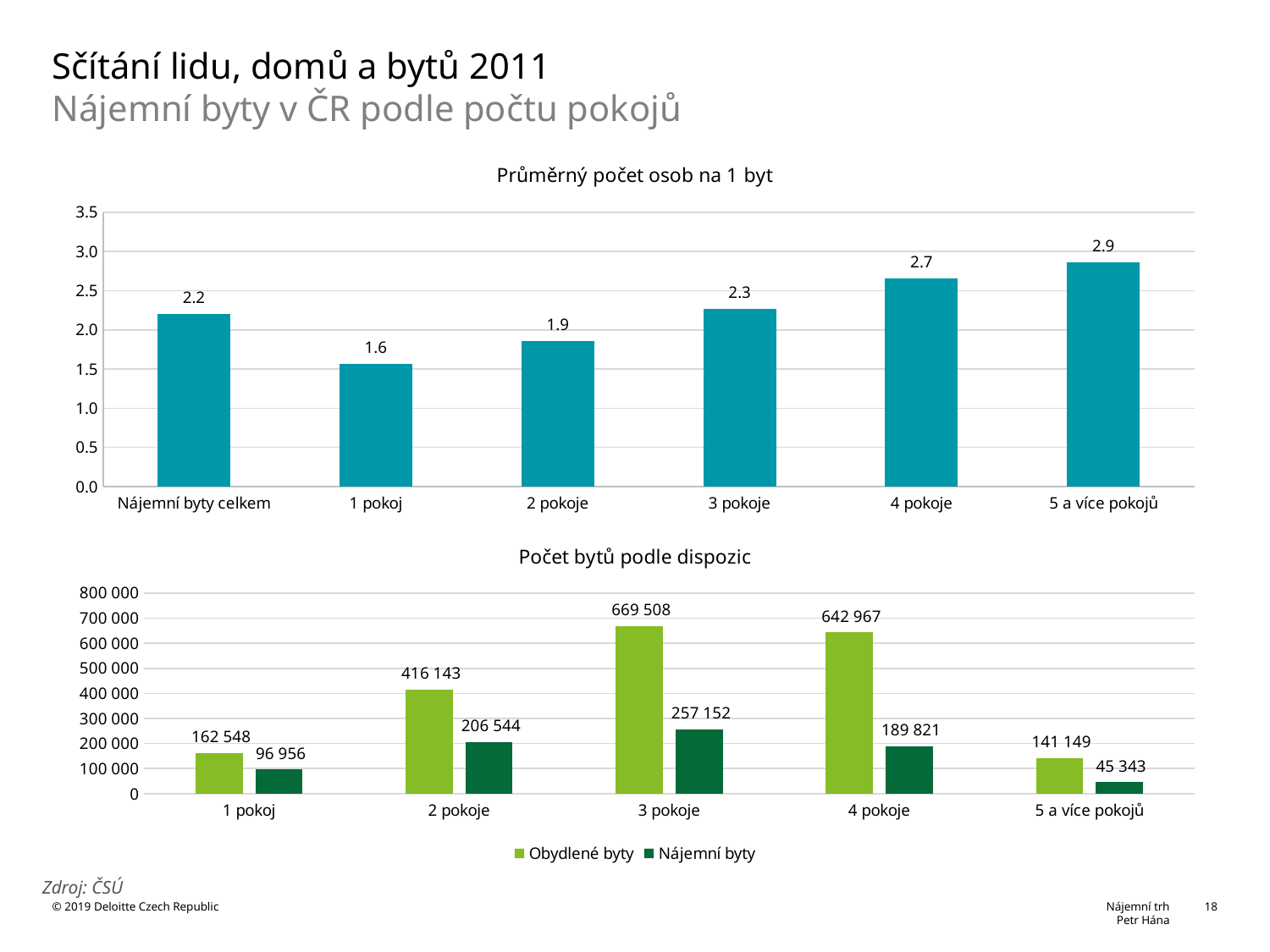
In the chart 'Průměrný počet osob na 1 byt', which category has the lowest value? 1 pokoj In the chart 'Počet bytů podle dispozic', how many series does the legend list? 2 What kind of chart is 'Počet bytů podle dispozic'? bar chart In the chart 'Průměrný počet osob na 1 byt', what is the value for '1 pokoj'? 1.6 In the chart 'Počet bytů podle dispozic', which category has the lowest value for 'Nájemní byty'? 5 a více pokojů In the chart 'Průměrný počet osob na 1 byt', do the values rise or fall from '1 pokoj' to '5 a více pokojů'? rise In the chart 'Počet bytů podle dispozic', what is the value of 'Nájemní byty' for '3 pokoje'? 257 152 In the chart 'Průměrný počet osob na 1 byt', how many categories are shown on the x axis? 6 In the chart 'Počet bytů podle dispozic', what is the value of 'Obydlené byty' for '5 a více pokojů'? 141 149 In the chart 'Počet bytů podle dispozic', which category has the highest value for 'Obydlené byty'? 3 pokoje In the chart 'Průměrný počet osob na 1 byt', which category has the highest value? 5 a více pokojů In the chart 'Počet bytů podle dispozic', what is the difference between 'Obydlené byty' and 'Nájemní byty' for '1 pokoj'? 65 592